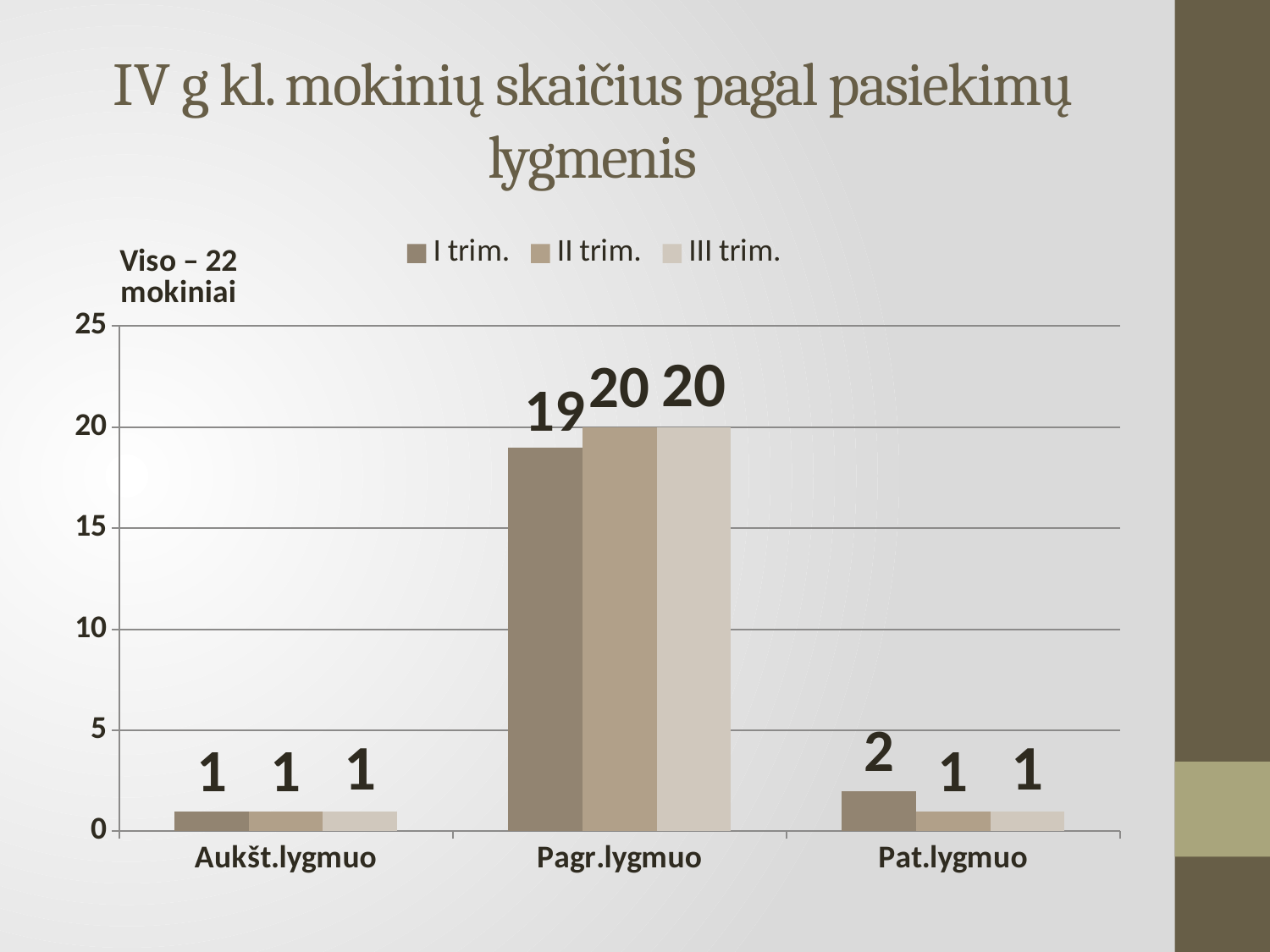
What is the value for II trim. in the Pagr.lygmuo category? 20 What is the value for III trim. in the Aukšt.lygmuo category? 1 What is the title of the chart on the slide? IV g kl. mokinių skaičius pagal pasiekimų lygmenis How many categories are shown on the x axis? 3 Which is larger in the Pat.lygmuo category: the I trim. value or the II trim. value? I trim. Which category has the highest value for I trim.? Pagr.lygmuo What is the value for I trim. in the Pat.lygmuo category? 2 What is the difference between the I trim. values for Pat.lygmuo and Aukšt.lygmuo? 1 What kind of chart is shown on the slide? bar chart What is the value for I trim. in the Pagr.lygmuo category? 19 How many series does the legend list? 3 What is the difference between the II trim. and I trim. values in the Pagr.lygmuo category? 1